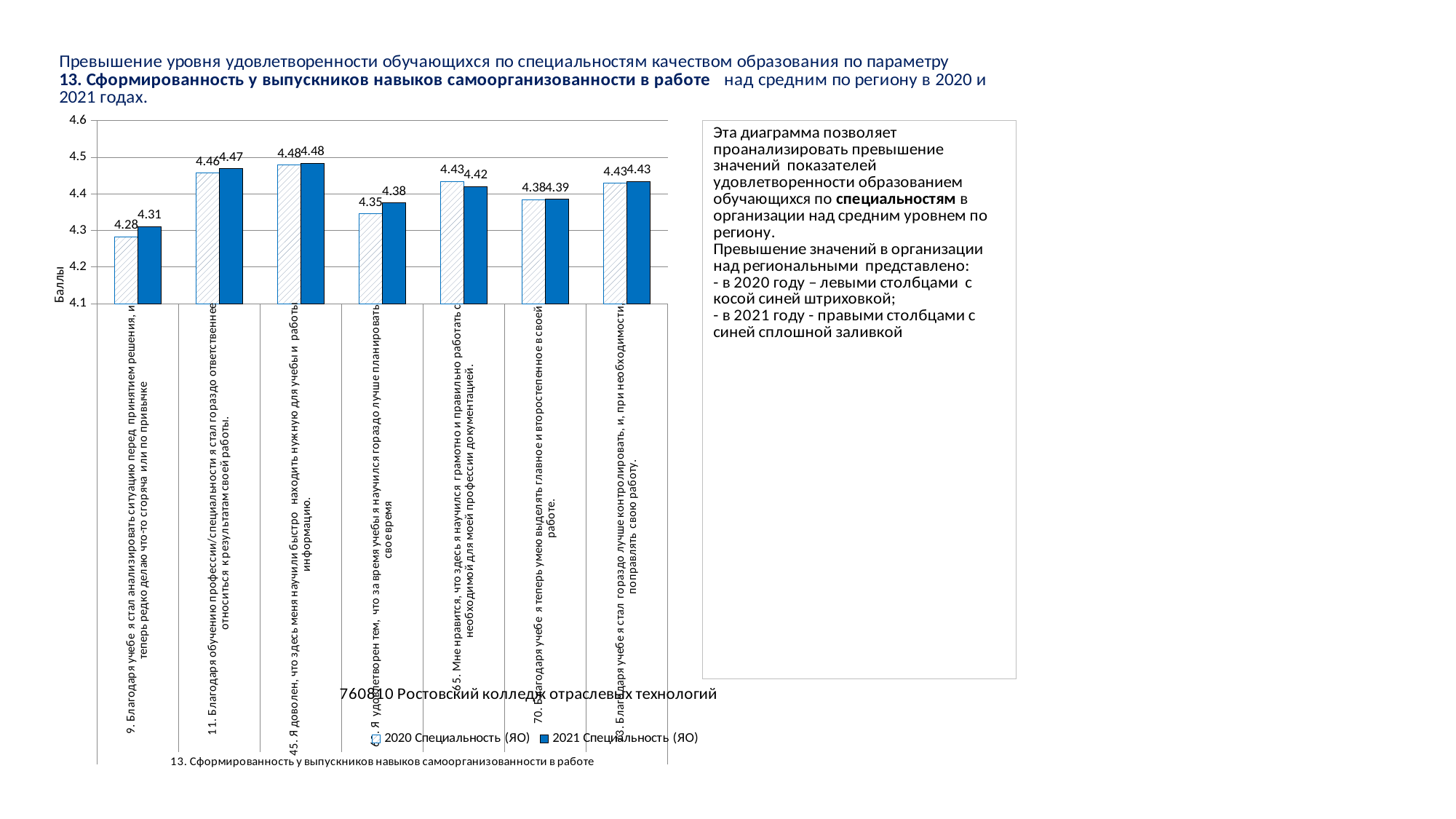
Which statement has the lowest 2021 Специальность (ЯО) value? 9. Благодаря учебе я стал анализировать ситуацию перед принятием решения Is the 2020 Специальность (ЯО) value for statement 11 greater or less than 4.4? greater What is the difference between the 2021 and 2020 Специальность (ЯО) values for statement 9? 0.03 How many categories (statements) are plotted on the x axis? 7 Which statement has the highest 2020 Специальность (ЯО) value? 45. Я доволен, что здесь меня научили быстро находить нужную для учебы и работы информацию What is the 2020 Специальность (ЯО) value for statement 9 (Благодаря учебе я стал анализировать ситуацию перед принятием решения)? 4.28 What is the 2021 Специальность (ЯО) value for statement 70 (Благодаря учебе я теперь умею выделять главное и второстепенное в своей работе)? 4.39 How many series does the legend list? 2 What type of chart is shown on the slide? bar chart For statement 65 (Мне нравится, что здесь я научился грамотно и правильно работать с документацией), which is larger: the 2020 or the 2021 value? 2020 What is the label of the vertical axis? Баллы